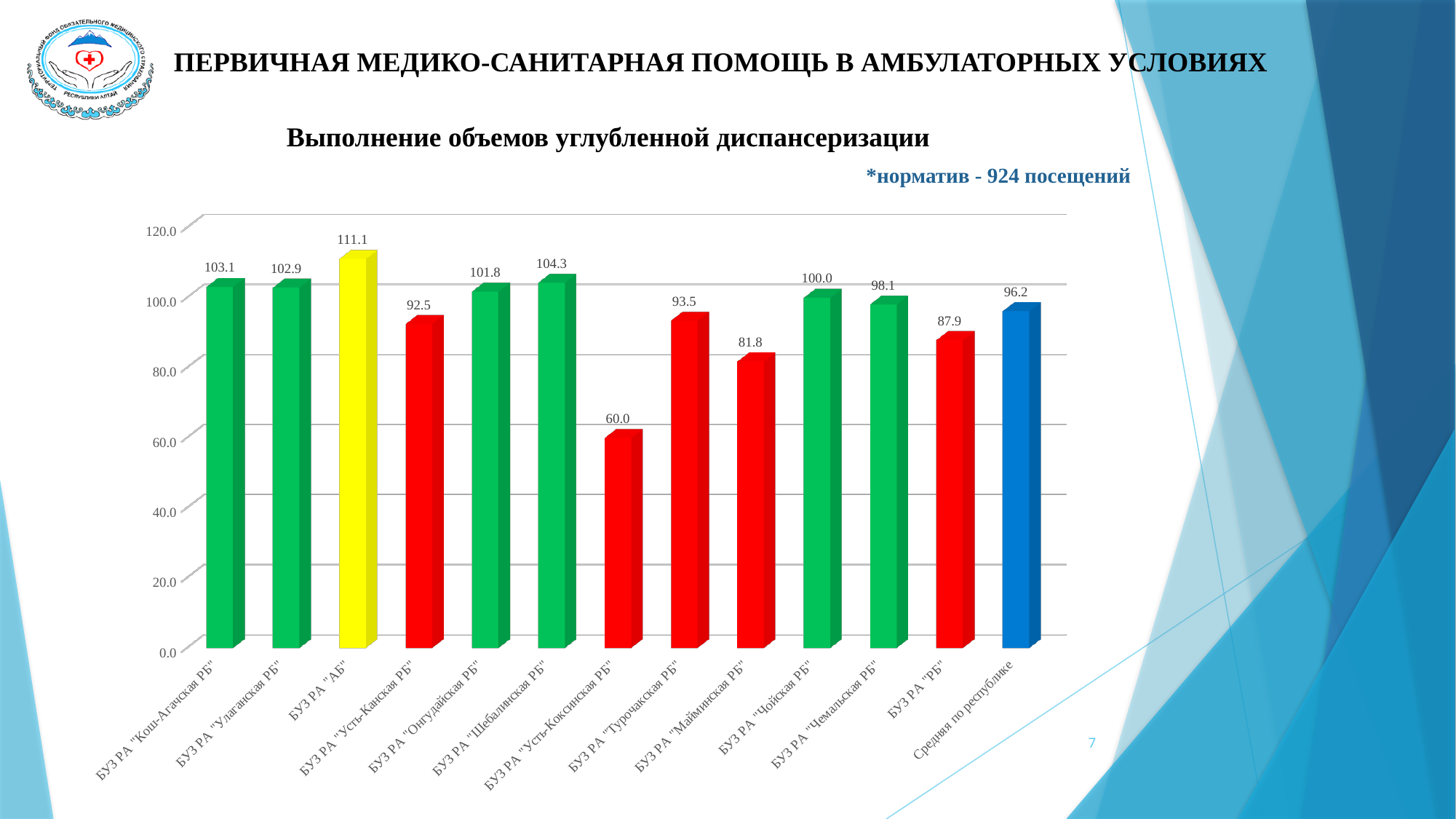
What is the value shown for Средняя по республике? 96.2 Which is larger, the value for БУЗ РА "Турочакская РБ" or БУЗ РА "Усть-Канская РБ"? БУЗ РА "Турочакская РБ" Is the value for БУЗ РА "РБ" greater or less than 100.0? less Which category has the lowest value? БУЗ РА "Усть-Коксинская РБ" How many categories are shown on the x axis? 13 What is the value for БУЗ РА "Чойская РБ"? 100.0 What is the value for БУЗ РА "Усть-Коксинская РБ"? 60.0 What kind of chart is shown on the slide? bar chart Which category has the highest value? БУЗ РА "АБ" What colour is the bar for БУЗ РА "АБ"? yellow What is the value for БУЗ РА "АБ"? 111.1 What is the difference between the values for БУЗ РА "Шебалинская РБ" and БУЗ РА "Майминская РБ"? 22.5